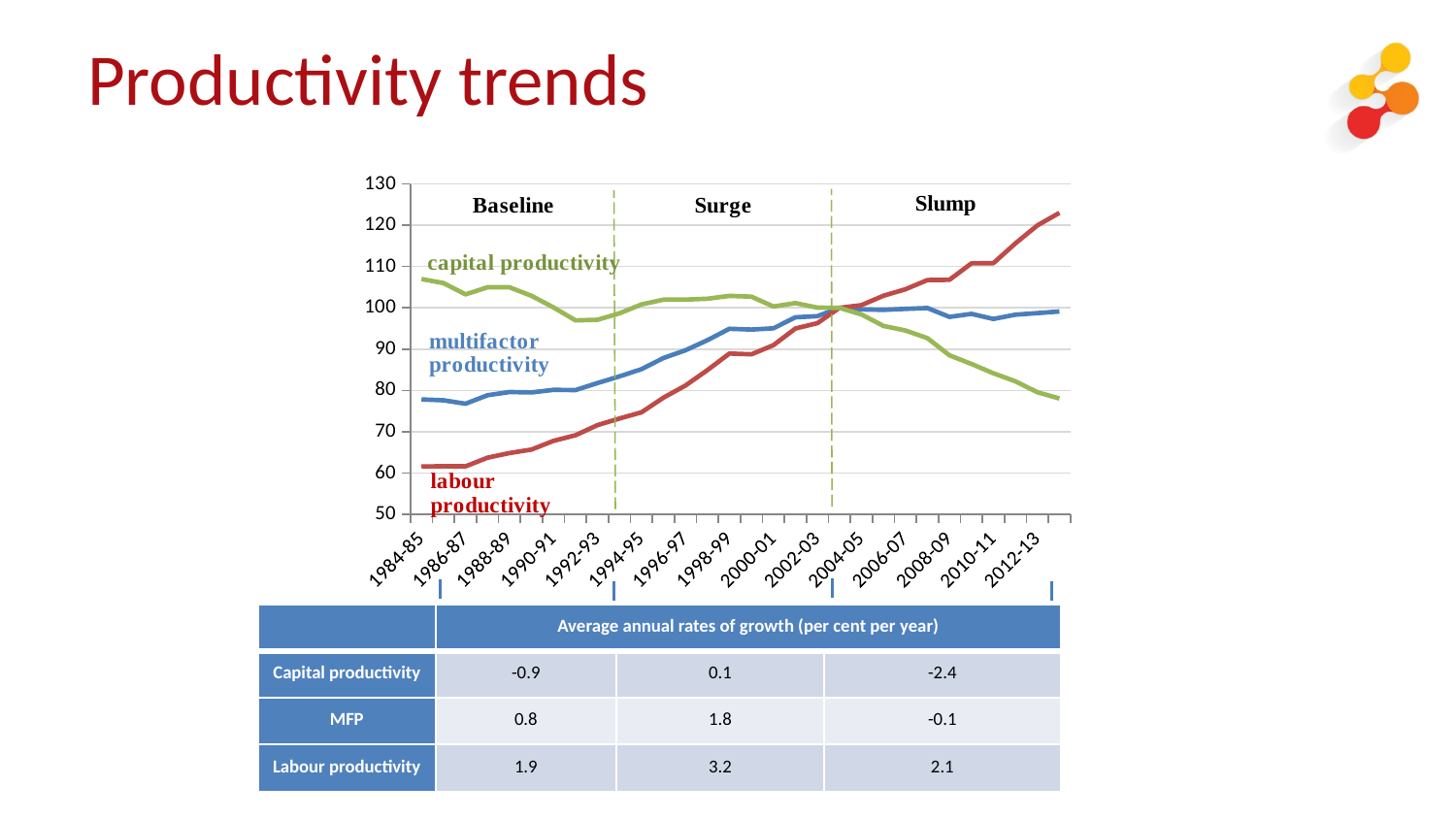
Which series has the highest value in 1984-85? capital productivity What are the names of the three periods marked on the chart? Baseline, Surge, Slump Does capital productivity rise or fall from 1984-85 to 2012-13? fall How many year labels are shown along the x axis of the chart? 15 How many productivity series are plotted on the chart? 3 Is the value for labour productivity in 1984-85 greater or less than 70? less Which series has the lowest value in 2012-13? capital productivity Does labour productivity rise or fall from 1984-85 to 2012-13? rise Which series has the highest value in 2012-13? labour productivity What kind of chart is shown on the slide? line chart Is the value for capital productivity in 2012-13 greater or less than 90? less Is the value for labour productivity in 2012-13 greater or less than 110? greater